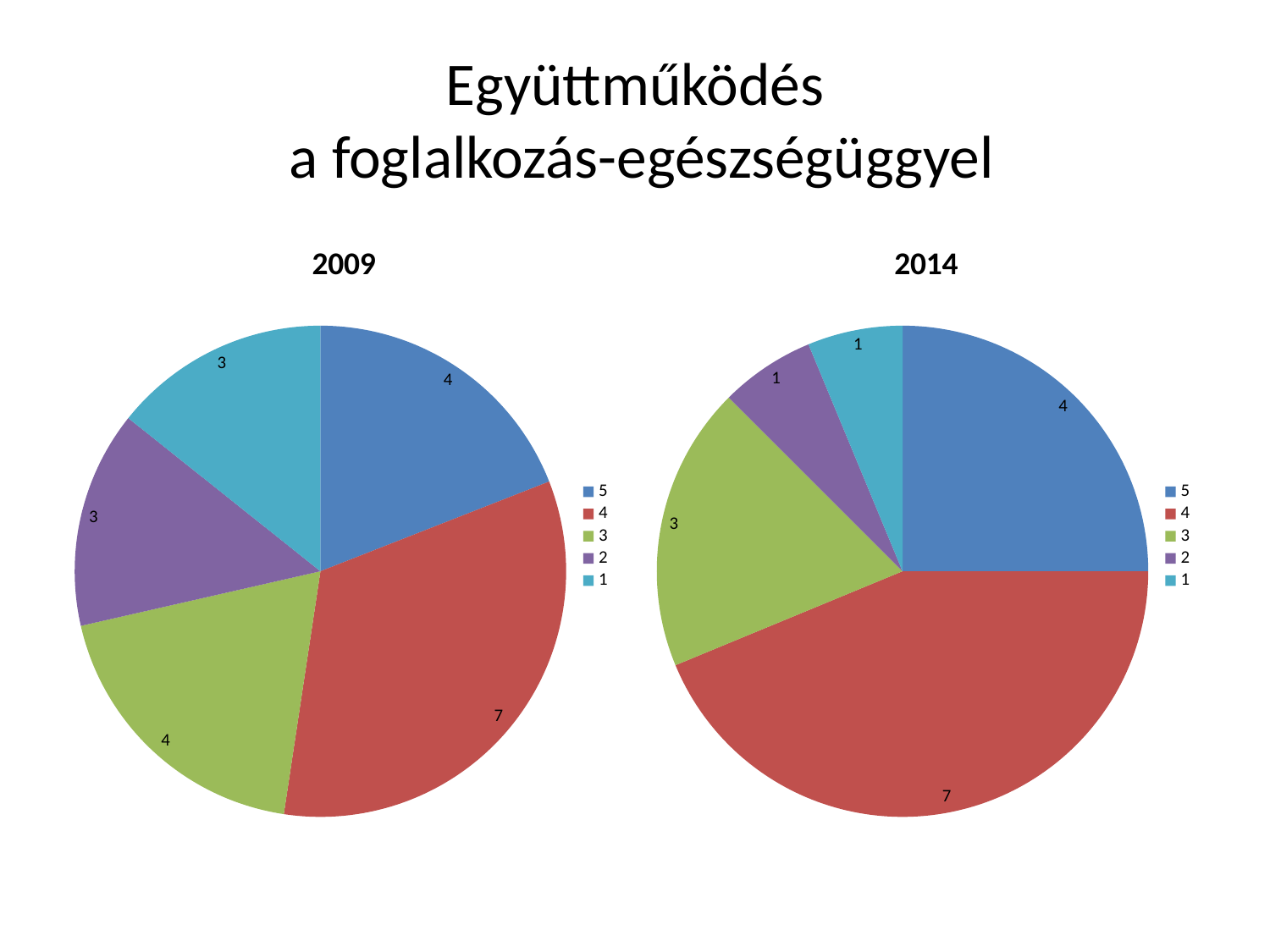
In the 2014 pie chart, which category has the largest slice? 4 How many entries does the legend of the 2014 pie chart list? 5 In the 2014 pie chart, which is larger, the slice for category 3 or the slice for category 1? category 3 In the 2014 pie chart, what share of the total does the slice for category 5 represent? 25% In the 2009 pie chart, what is the difference between the value for category 4 and the value for category 2? 4 In the 2009 pie chart, which category has the largest slice? 4 In the 2009 pie chart, what is the value of the slice for category 4? 7 How many slices does the 2009 pie chart have? 5 In the 2014 pie chart, what is the value of the slice for category 2? 1 In the 2014 pie chart, what is the value of the slice for category 3? 3 What type of chart is used for the 2009 data? pie chart In the 2014 pie chart, what is the difference between the value for category 5 and the value for category 1? 3